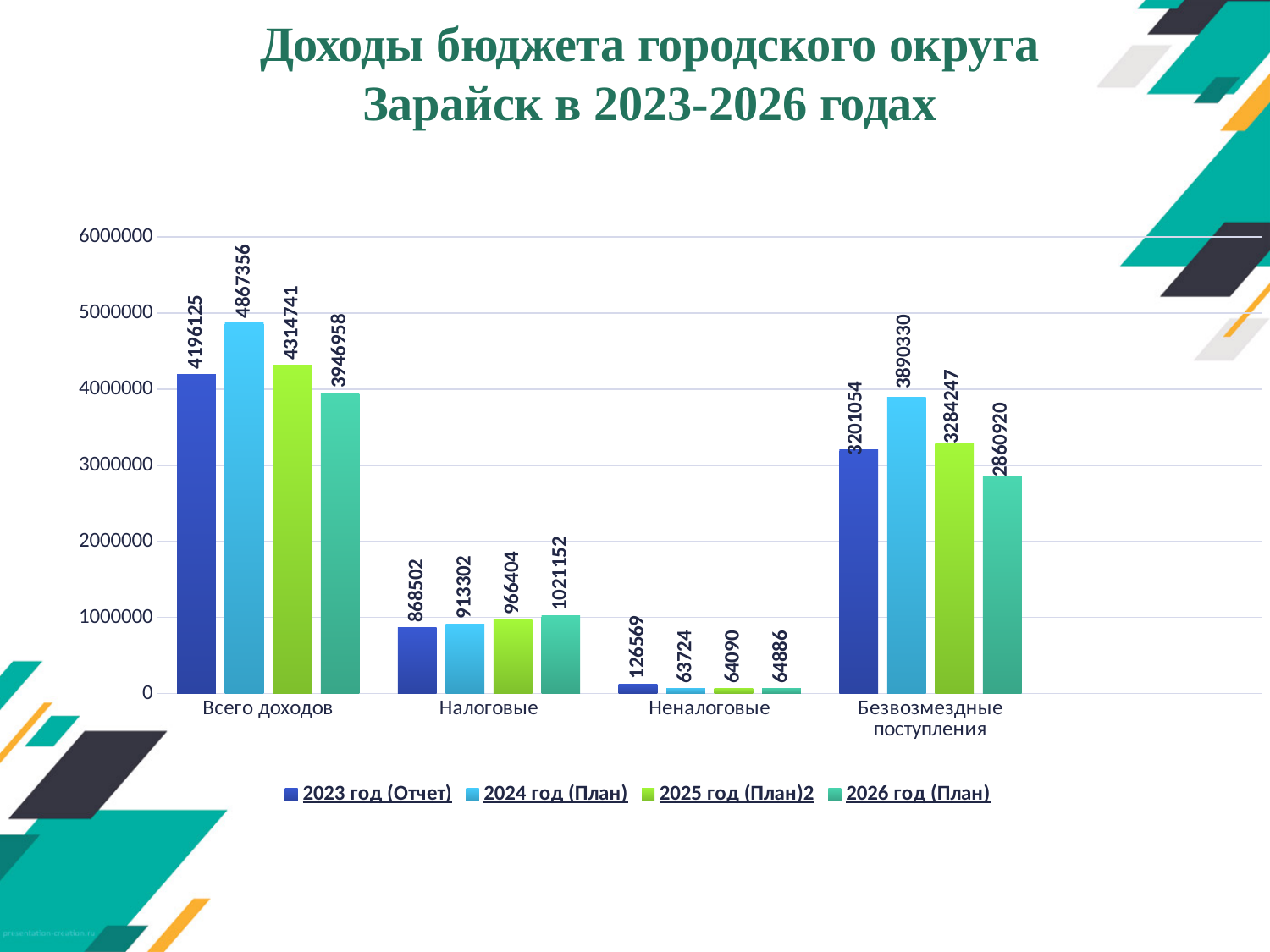
What is the value for Всего доходов in the 2024 год (План) series? 4867356 What is the value for Безвозмездные поступления in the 2025 год (План)2 series? 3284247 What type of chart is shown on the slide? bar chart What is the value for Неналоговые in the 2023 год (Отчет) series? 126569 Do the values for Налоговые rise or fall from 2023 год (Отчет) to 2026 год (План)? rise How many series does the legend list? 4 For Всего доходов, which series has the highest value? 2024 год (План) Which is larger for Безвозмездные поступления: the 2023 год (Отчет) value or the 2026 год (План) value? 2023 год (Отчет) What is the difference between the 2024 год (План) and 2023 год (Отчет) values for Всего доходов? 671231 How many categories are shown on the x axis? 4 In the 2024 год (План) series, which category has the lowest value? Неналоговые What is the value for Налоговые in the 2026 год (План) series? 1021152